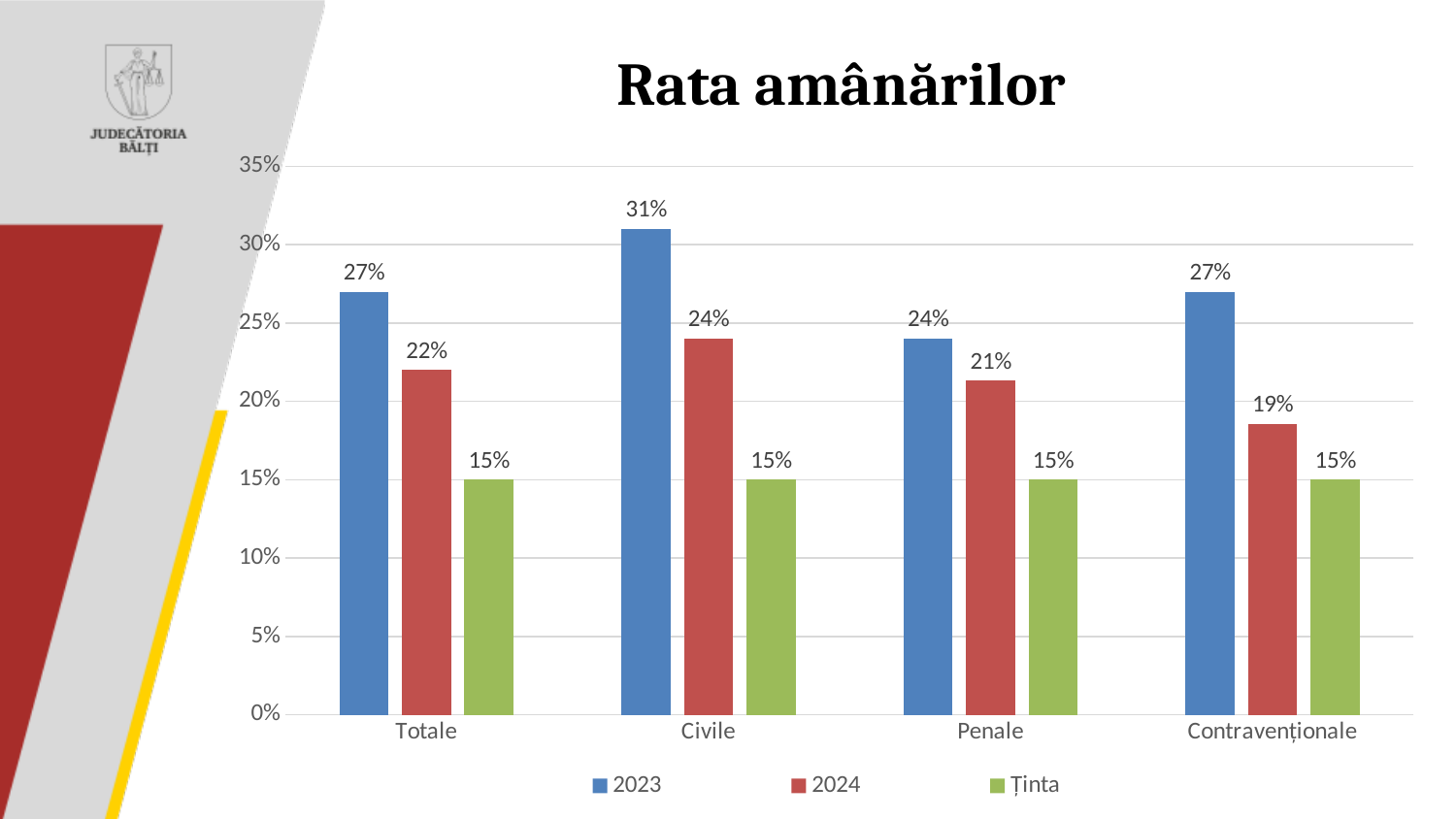
What is the difference between the 2023 and 2024 values for Totale? 5% Is the 2024 value for Civile greater or less than 20%? greater What is the 2023 value for Civile? 31% What kind of chart is shown on the slide? Bar chart What is the Ținta value for Penale? 15% How many series does the legend list? 3 Which category has the lowest 2024 value? Contravenționale How many categories are shown on the x axis? 4 What is the title of the chart? Rata amânărilor Which is larger for Penale: the 2023 value or the 2024 value? 2023 Which category has the highest 2023 value? Civile What is the 2024 value for Contravenționale? 19%